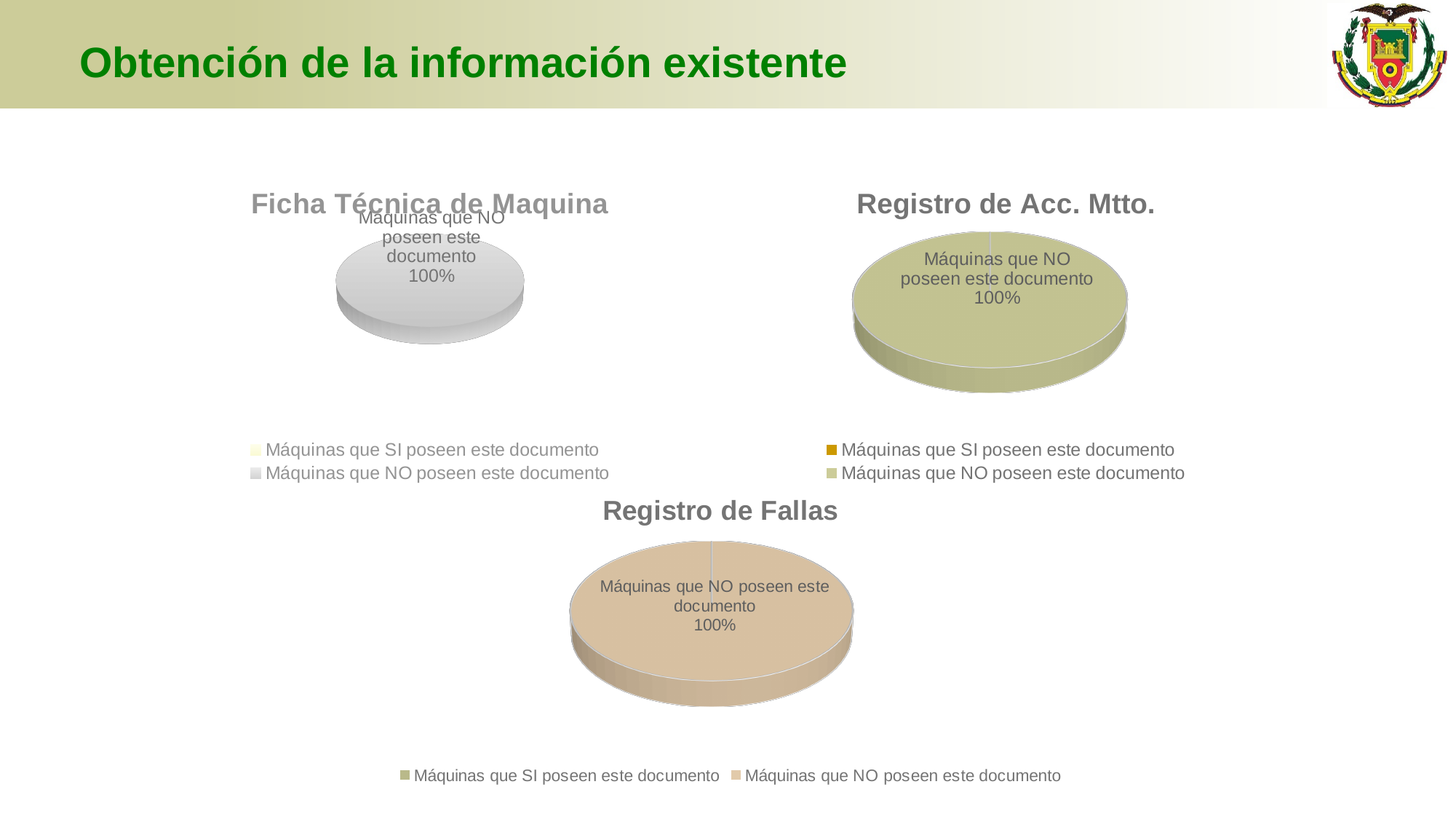
How many entries does the legend of the 'Registro de Acc. Mtto.' chart list? 2 In the 'Registro de Fallas' chart, what share is shown for 'Máquinas que NO poseen este documento'? 100% What kind of chart is the 'Ficha Técnica de Maquina' chart? Pie chart What is the title of the chart at the bottom of the slide? Registro de Fallas How many entries does the legend of the 'Registro de Fallas' chart list? 2 In the 'Registro de Acc. Mtto.' chart, which category has the largest share? Máquinas que NO poseen este documento In the 'Ficha Técnica de Maquina' chart, which category has the largest share? Máquinas que NO poseen este documento In the 'Registro de Acc. Mtto.' chart, what share is shown for 'Máquinas que NO poseen este documento'? 100% How many pie charts are shown on the slide? 3 In the 'Ficha Técnica de Maquina' chart, what share is shown for 'Máquinas que NO poseen este documento'? 100% In the 'Registro de Fallas' chart, which category has the largest share? Máquinas que NO poseen este documento What is the title of the chart at the top right of the slide? Registro de Acc. Mtto.